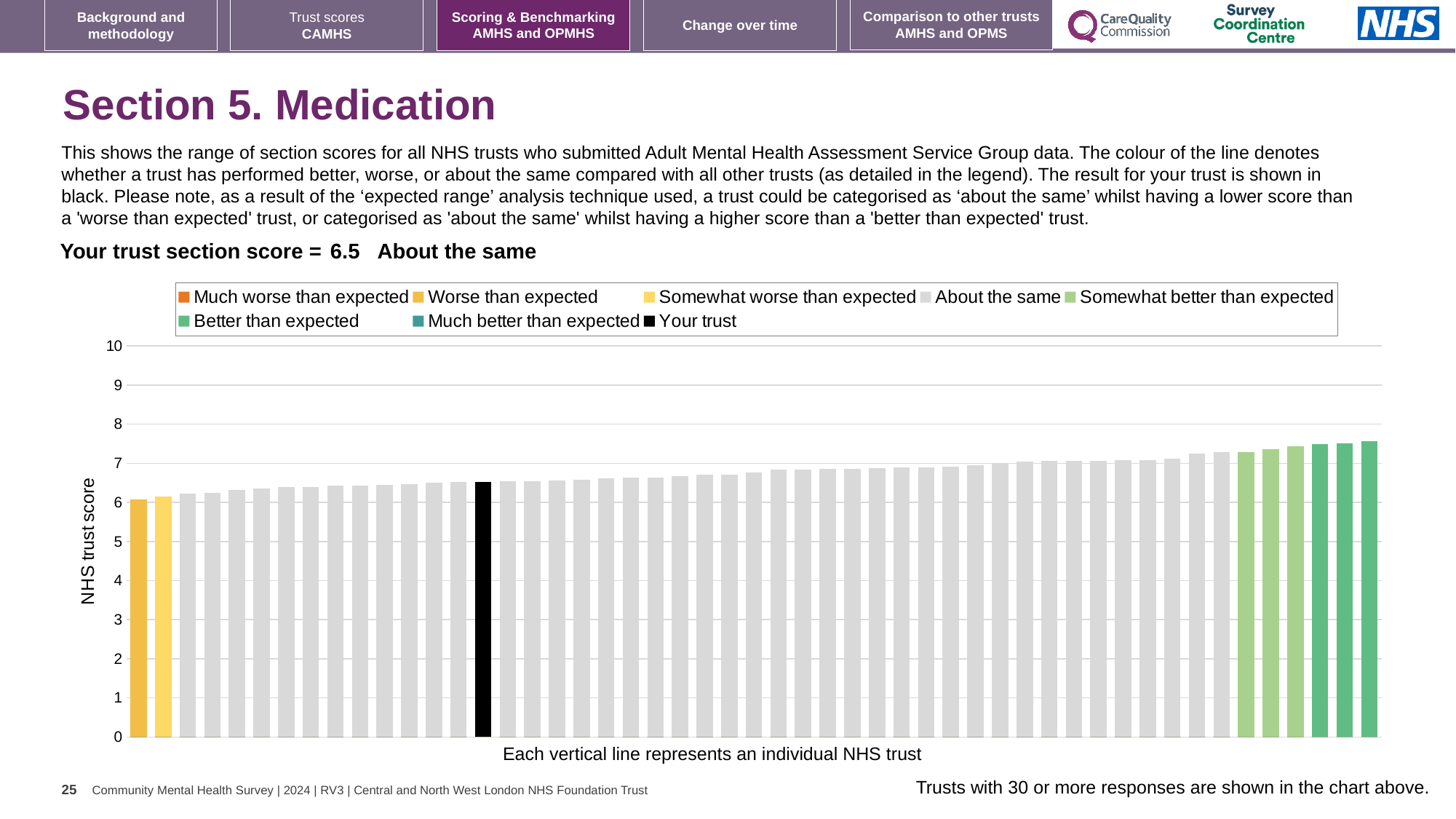
Is the value of the shortest bar greater or less than 5? greater What is the title of the y axis? NHS trust score What is the section score for your trust? 6.5 What is the highest value shown on the y axis? 10 Do the bar values rise or fall from left to right along the x axis? rise Is the value of the black bar (your trust) greater or less than 5? greater What kind of chart is shown on the slide? bar chart How many bars are coloured black? 1 Is the value of the tallest bar greater or less than 8? less Which performance category is your trust placed in? About the same How many entries does the chart legend list? 8